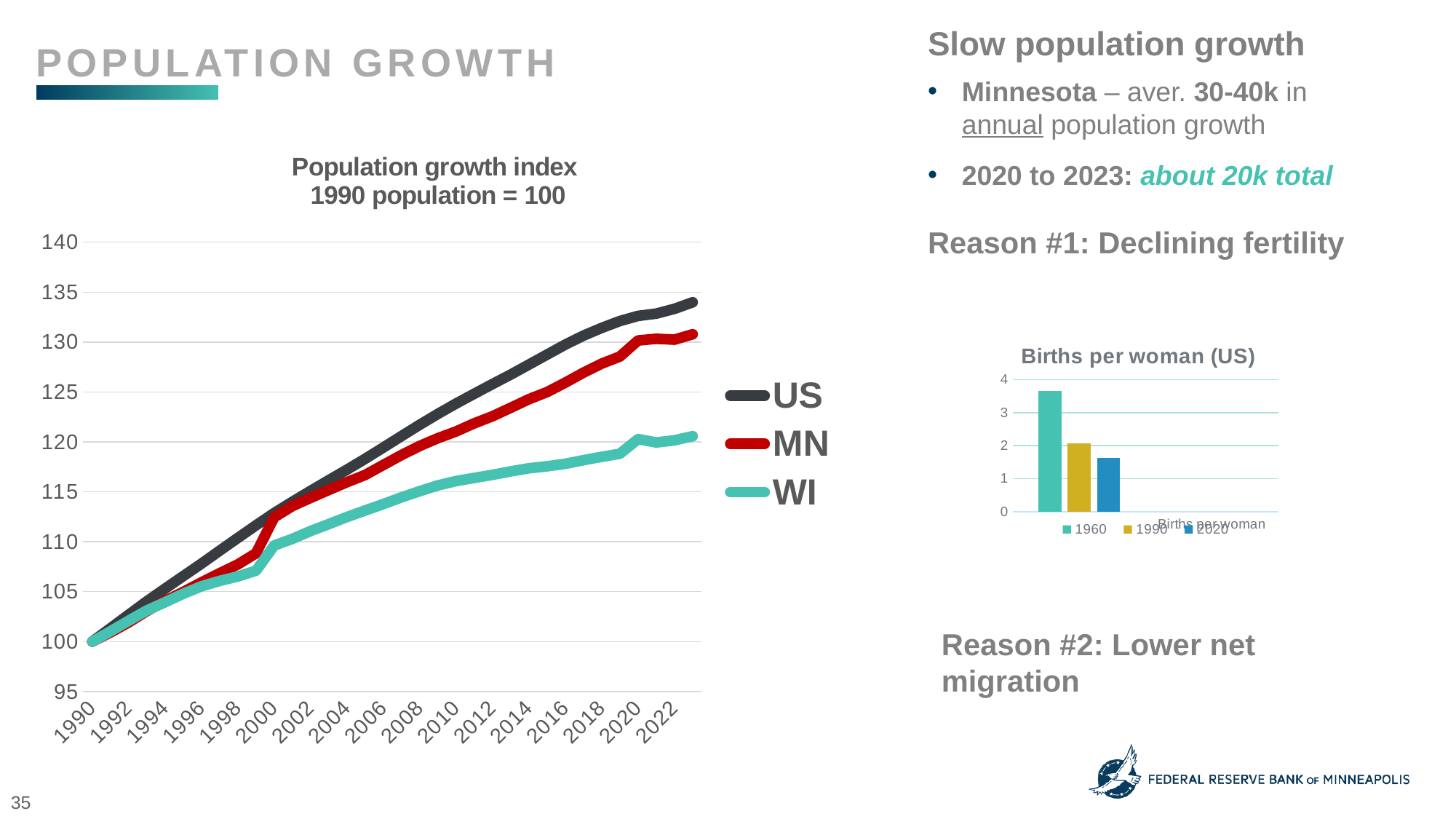
In the 'Population growth index' chart, which series has the lowest value in 2022? WI In the 'Population growth index' chart, what is the index value for all three series in 1990? 100 In the 'Births per woman (US)' chart, which year has the highest value? 1960 In the 'Population growth index' chart, which series has the highest value in 2022? US In the 'Population growth index' chart, is the WI value in 2022 greater or less than 125? less In the 'Population growth index' chart, do the values rise or fall from 1990 to 2022? rise In the 'Population growth index' chart, is the US value in 2022 greater or less than 130? greater In the 'Births per woman (US)' chart, is the value for 1960 greater or less than 3? greater What kind of chart is the 'Population growth index' chart? line chart What kind of chart is the 'Births per woman (US)' chart? bar chart How many series does the legend of the 'Population growth index' chart list? 3 In the 'Births per woman (US)' chart, how many bars are plotted? 3